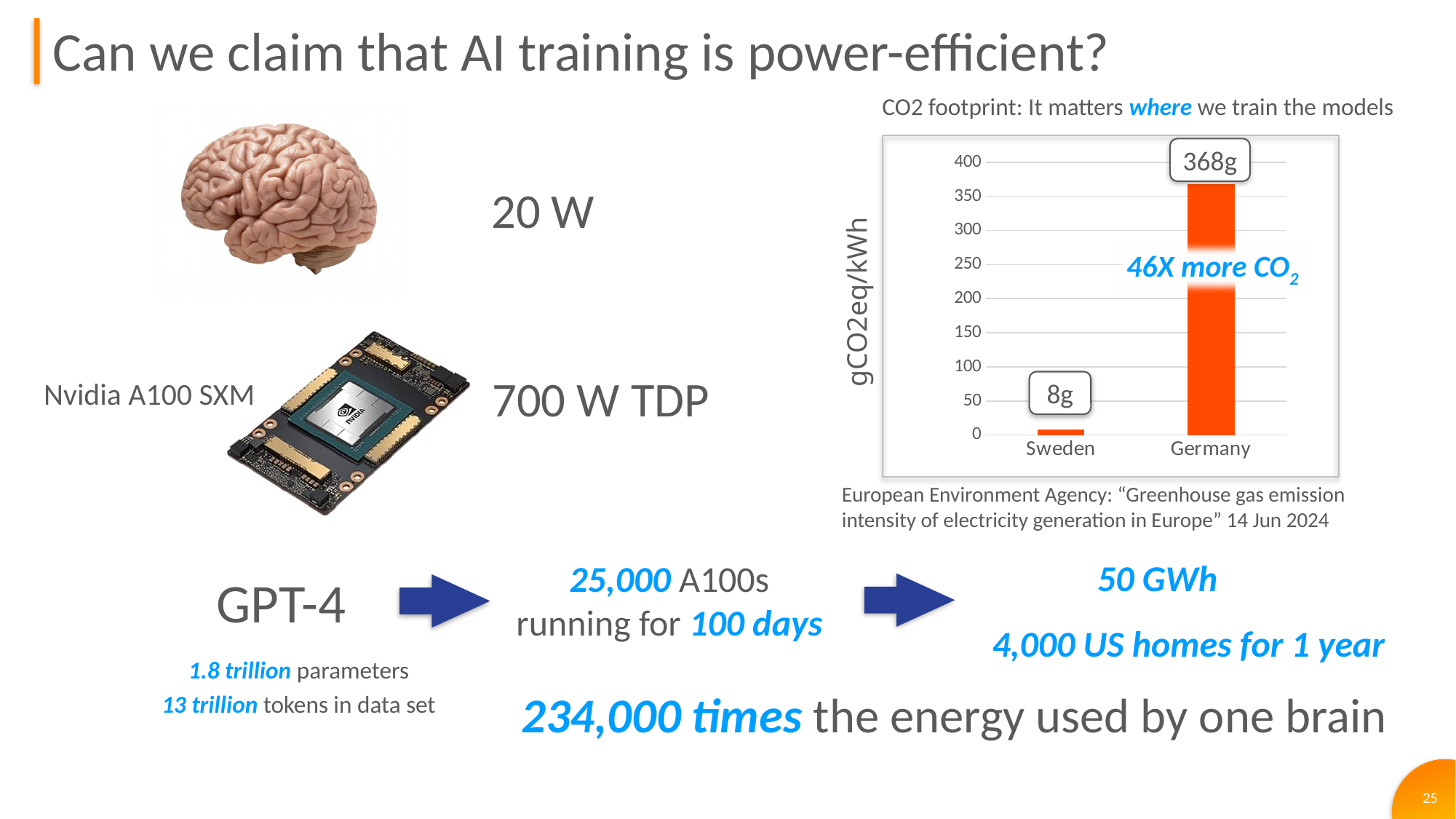
Is the value for Sweden greater or less than 50 in the CO2 footprint chart? less Is the value for Germany larger or smaller than the value for Sweden in the CO2 footprint chart? larger According to the annotation on the chart, how many times more CO2 does Germany produce compared to Sweden? 46X What is the value for Sweden in the CO2 footprint chart? 8g What is the value for Germany in the CO2 footprint chart? 368g Which country has the lower value in the CO2 footprint chart? Sweden How many countries are shown in the CO2 footprint chart? 2 What is the difference between the values for Germany and Sweden in the CO2 footprint chart? 360g Which country has the higher value in the CO2 footprint chart? Germany What kind of chart is the CO2 footprint chart? bar chart Is the value for Germany greater or less than 350 in the CO2 footprint chart? greater What is the label of the vertical axis in the CO2 footprint chart? gCO2eq/kWh